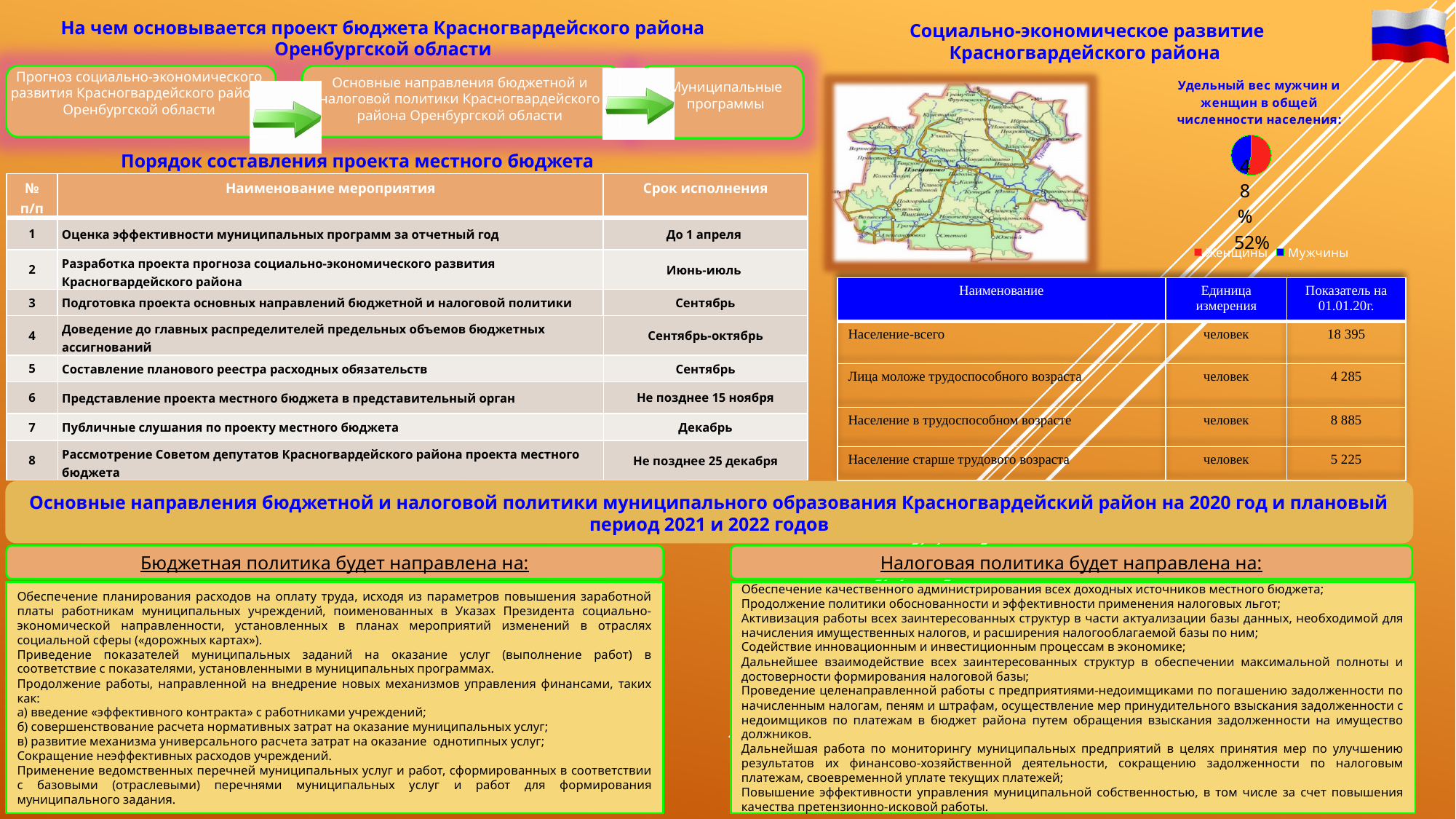
What colour represents 'Мужчины' in the pie chart legend? blue How many series does the legend of the pie chart list? 2 What are the two legend entries of the pie chart? Женщины, Мужчины What kind of chart is shown under the heading 'Удельный вес мужчин и женщин в общей численности населения'? pie chart Which two percentage values are printed on the pie chart? 48% and 52% How many slices does the pie chart have? 2